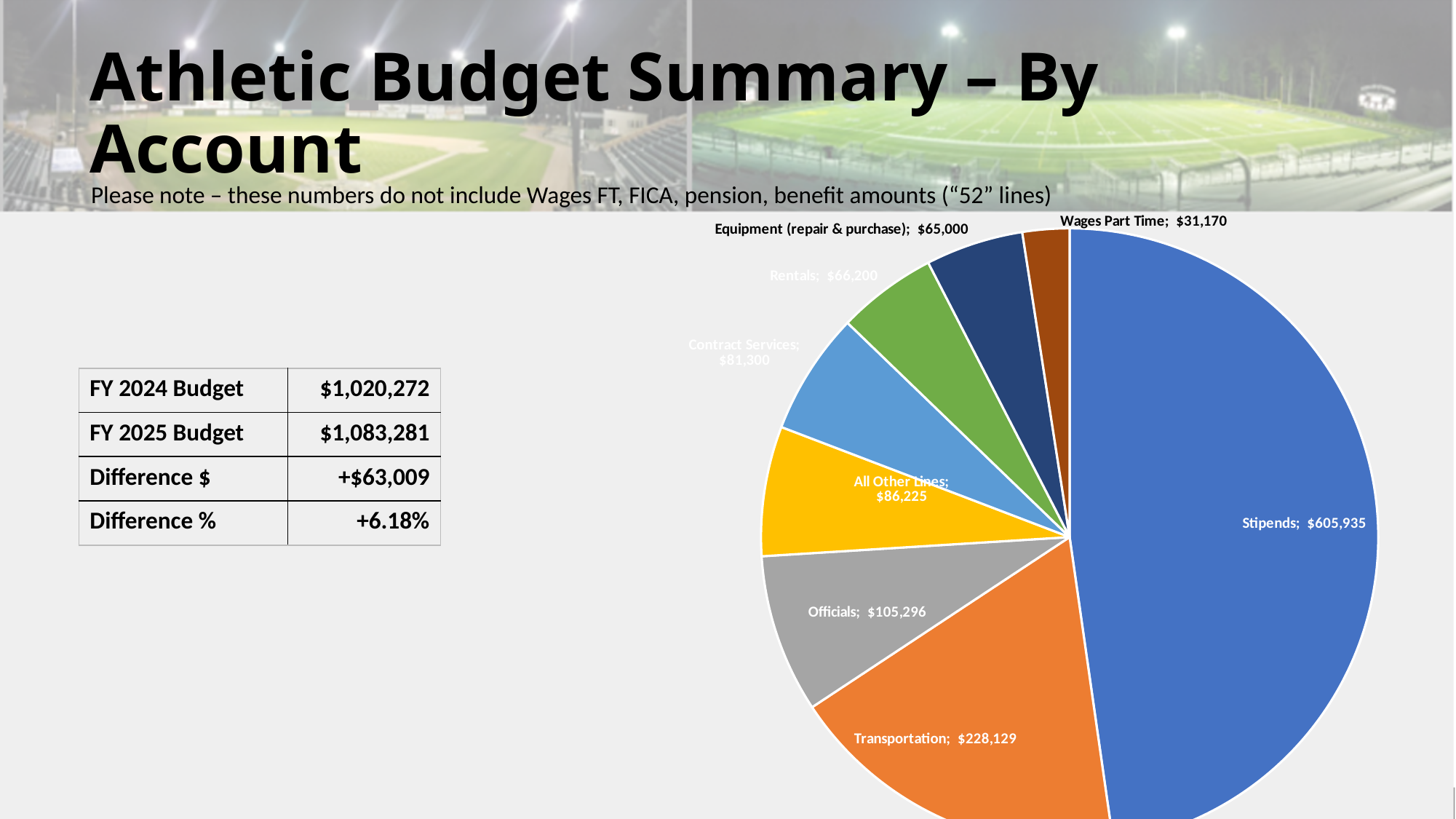
What is the difference between the Transportation and Officials values in the pie chart? $122,833 What is the value shown for Wages Part Time in the pie chart? $31,170 What is the value shown for Equipment (repair & purchase) in the pie chart? $65,000 Which is larger in the pie chart, Contract Services or All Other Lines? All Other Lines What is the value shown for Officials in the pie chart? $105,296 What is the value shown for Stipends in the pie chart? $605,935 What kind of chart is shown on the slide? Pie chart How many categories are shown in the pie chart? 8 Which category has the largest slice in the pie chart? Stipends Which category has the smallest slice in the pie chart? Wages Part Time What is the value shown for Transportation in the pie chart? $228,129 What is the difference between the Rentals and Equipment (repair & purchase) values in the pie chart? $1,200